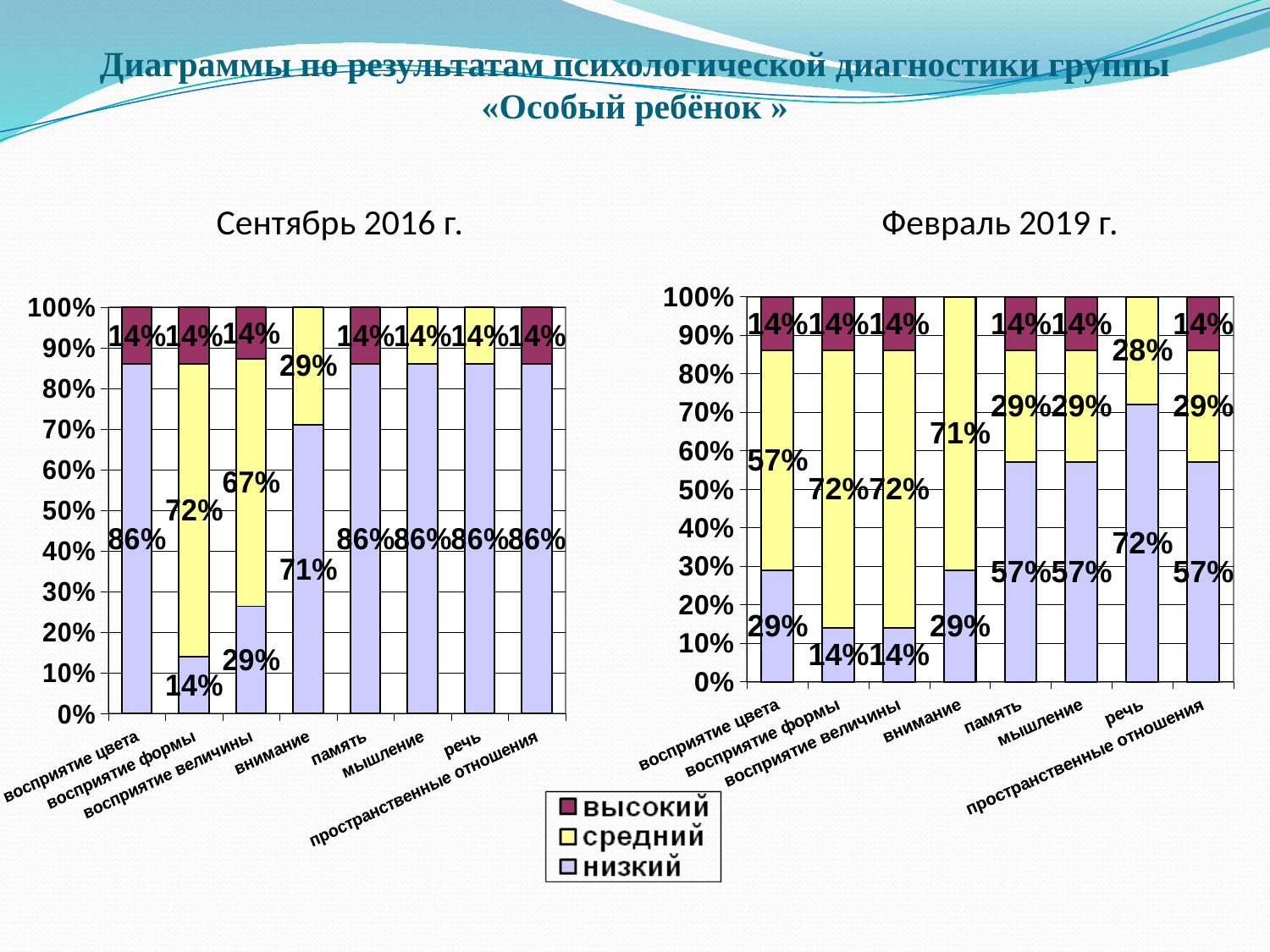
In the "Сентябрь 2016 г." chart, what is the value of "средний" for "восприятие формы"? 72% Which legend entry is shown in dark red? высокий In the "Февраль 2019 г." chart, what is the difference between "низкий" and "средний" for "память"? 28% How many categories are shown on the x axis of the "Февраль 2019 г." chart? 8 In the "Февраль 2019 г." chart, what is the value of "низкий" for "речь"? 72% In the "Сентябрь 2016 г." chart, what is the value of "низкий" for "внимание"? 71% In the "Сентябрь 2016 г." chart, which is larger for "восприятие формы": "низкий" or "средний"? средний In the "Сентябрь 2016 г." chart, what is the value of "низкий" for "восприятие цвета"? 86% In the "Февраль 2019 г." chart, what is the value of "средний" for "внимание"? 71% What kind of chart is the "Сентябрь 2016 г." chart? Stacked bar chart How many series does the legend list? 3 In the "Февраль 2019 г." chart, what is the value of "средний" for "восприятие цвета"? 57%